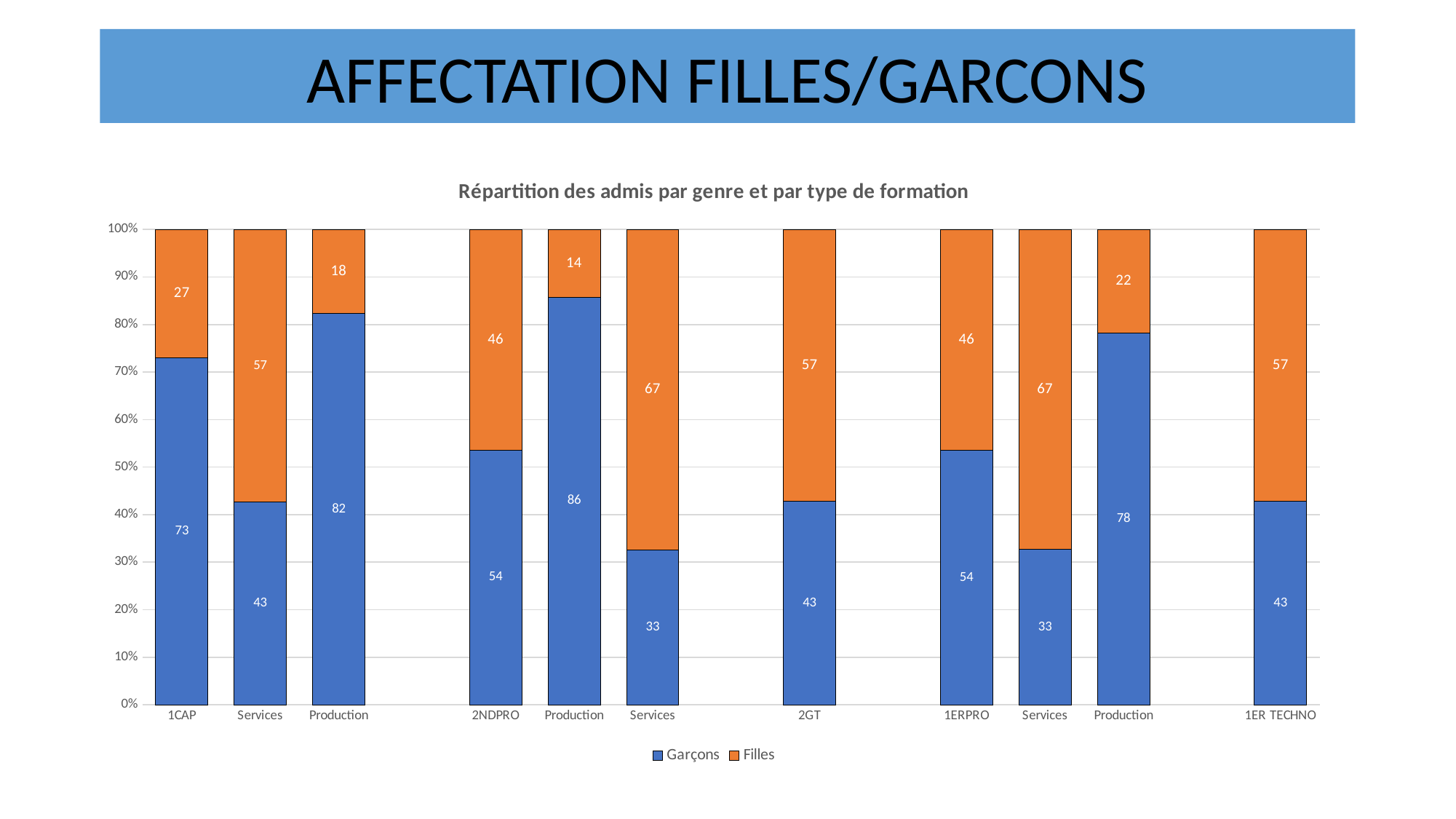
What is the Filles value for 2GT? 57 For 1CAP, which is larger, the Garçons value or the Filles value? Garçons Is the Garçons share for 1ER TECHNO greater or less than 50%? less Which is larger, the Garçons value for 1ERPRO or the Garçons value for 2GT? 1ERPRO What kind of chart is shown on the slide? Stacked bar chart For 2GT, what is the difference between the Filles value and the Garçons value? 14 What is the Garçons value for 1CAP? 73 What is the Garçons value for 2NDPRO? 54 What is the title of the chart? Répartition des admis par genre et par type de formation How many series does the legend list? 2 How many bars (categories) are plotted along the x axis? 11 What is the Filles value for 1ER TECHNO? 57